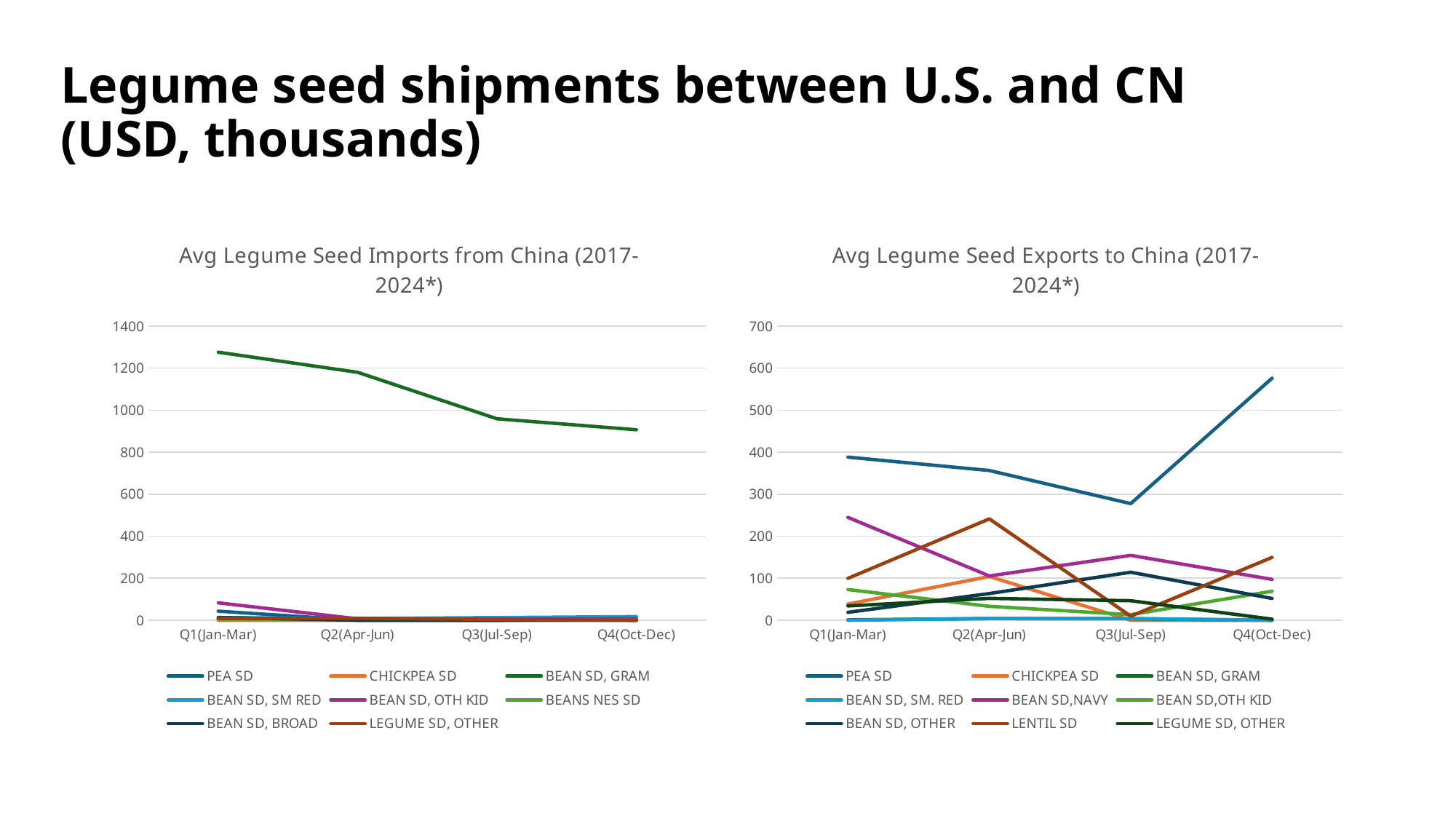
In the 'Avg Legume Seed Imports from China (2017-2024*)' chart, does the BEAN SD, GRAM line rise or fall from Q1 to Q4? fall How many series does the legend of the 'Avg Legume Seed Exports to China (2017-2024*)' chart list? 9 How many quarters are shown on the x axis of the 'Avg Legume Seed Imports from China (2017-2024*)' chart? 4 In the 'Avg Legume Seed Imports from China (2017-2024*)' chart, which series has the highest values? BEAN SD, GRAM In the 'Avg Legume Seed Imports from China (2017-2024*)' chart, is the BEAN SD, GRAM value at Q4(Oct-Dec) greater or less than 1000? less How many series does the legend of the 'Avg Legume Seed Imports from China (2017-2024*)' chart list? 8 In the 'Avg Legume Seed Exports to China (2017-2024*)' chart, which series has the highest value at Q4(Oct-Dec)? PEA SD In the 'Avg Legume Seed Exports to China (2017-2024*)' chart, is the LENTIL SD value at Q2(Apr-Jun) greater or less than 200? greater What kind of chart is the 'Avg Legume Seed Imports from China (2017-2024*)' chart? line chart In the 'Avg Legume Seed Exports to China (2017-2024*)' chart, is the PEA SD value at Q4(Oct-Dec) greater or less than 500? greater In the 'Avg Legume Seed Exports to China (2017-2024*)' chart, is the PEA SD value larger at Q1(Jan-Mar) or at Q4(Oct-Dec)? Q4(Oct-Dec)